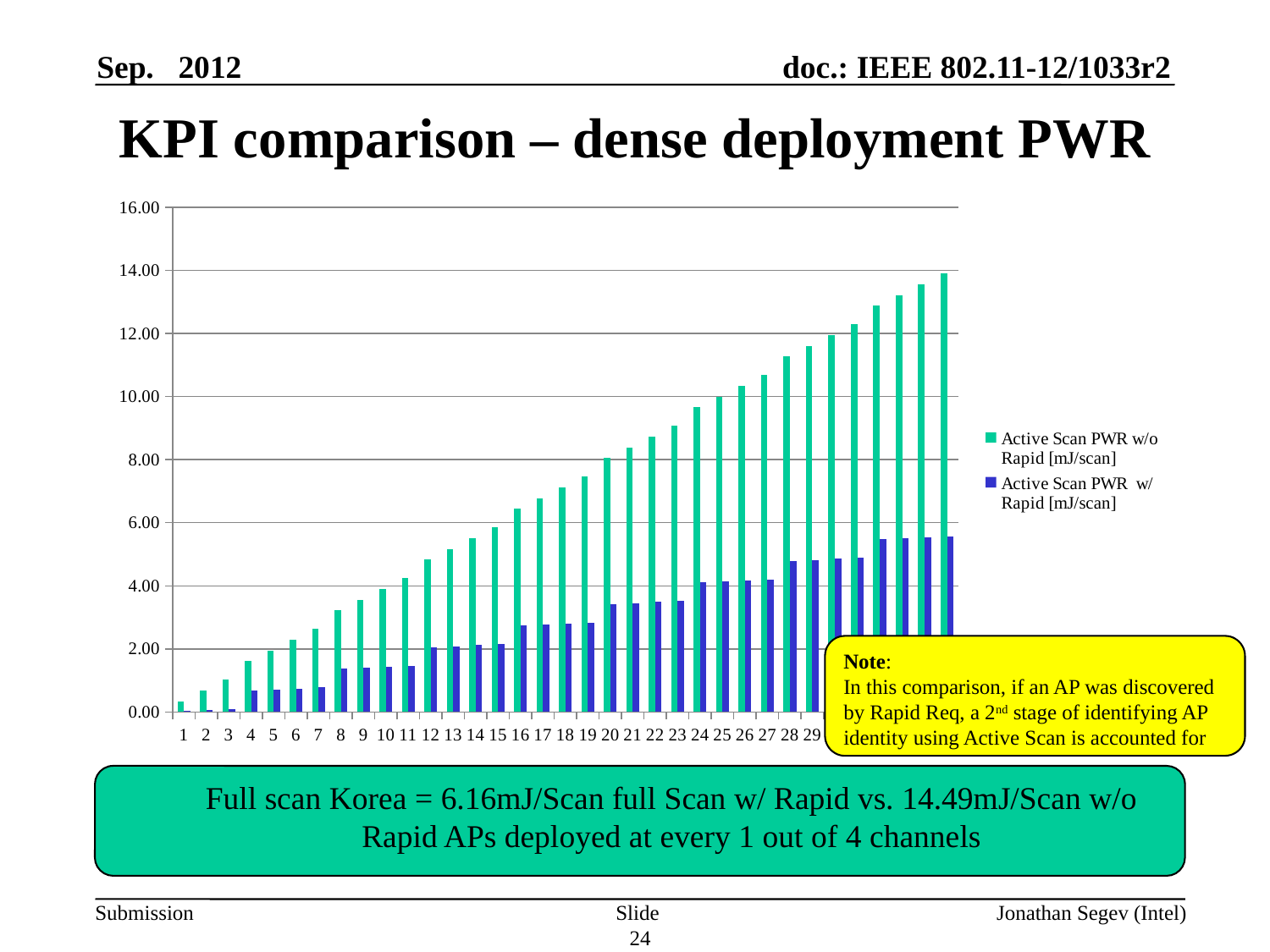
Which colour represents the Active Scan PWR w/ Rapid [mJ/scan] series? blue Do the values for Active Scan PWR w/o Rapid rise or fall as the category number increases along the x axis? rise Is the value for Active Scan PWR w/ Rapid at category 8 greater or less than 1.00? greater Is the value for Active Scan PWR w/o Rapid at category 24 greater or less than 10.00? less What kind of chart is shown on the slide? bar chart What is the title of the slide containing the chart? KPI comparison – dense deployment PWR At category 15, which series has the larger value: Active Scan PWR w/o Rapid or Active Scan PWR w/ Rapid? Active Scan PWR w/o Rapid How many series does the legend list? 2 Is the value for Active Scan PWR w/o Rapid at category 16 greater or less than 6.00? greater Which category has the lowest value for Active Scan PWR w/o Rapid [mJ/scan]? 1